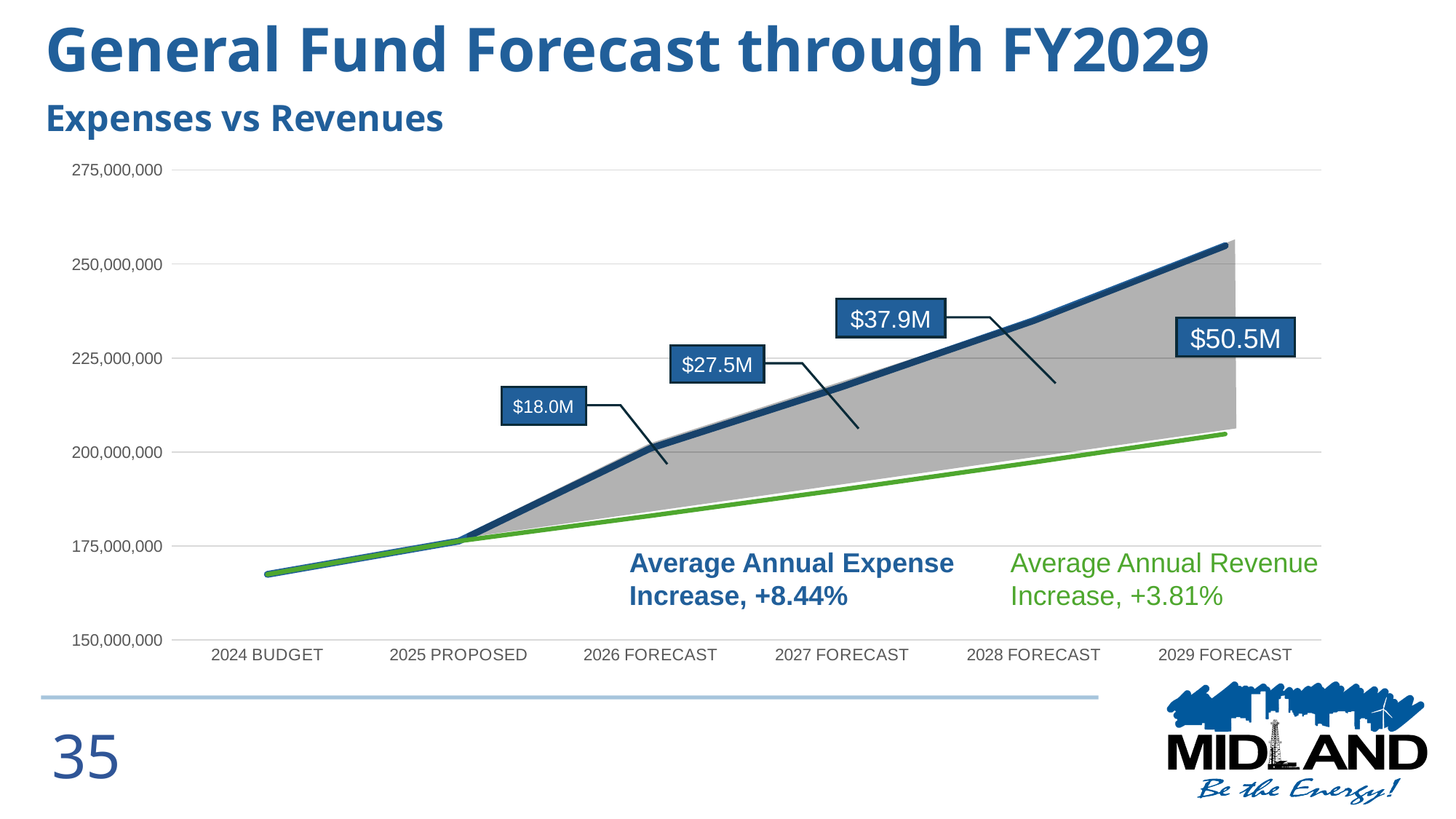
How much larger is the labelled gap for the 2029 Forecast than for the 2026 Forecast? $32.5M What is the labelled gap between expenses and revenues for the 2026 Forecast? $18.0M What is the labelled gap between expenses and revenues for the 2029 Forecast? $50.5M In which year is the labelled gap between expenses and revenues the largest? 2029 Forecast What is the labelled gap between expenses and revenues for the 2028 Forecast? $37.9M How many fiscal-year categories are shown along the x axis? 6 What is the average annual expense increase stated on the chart? +8.44% Is the expense value for the 2029 Forecast greater or less than 250,000,000? greater What kind of chart is shown on the slide? line chart Do expenses rise or fall from the 2024 Budget to the 2029 Forecast? rise Is the revenue value for the 2024 Budget greater or less than 175,000,000? less What is the labelled gap between expenses and revenues for the 2027 Forecast? $27.5M